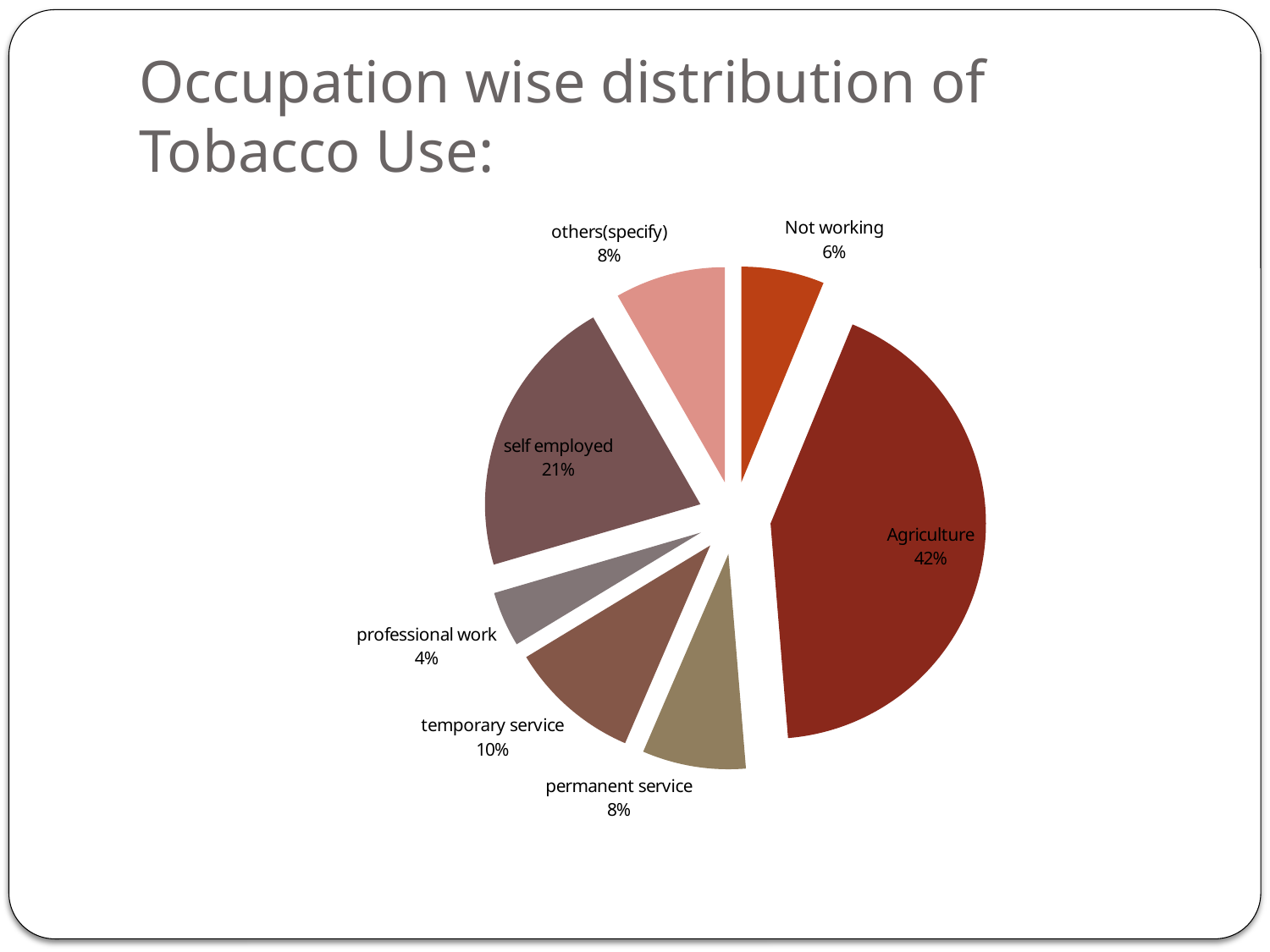
What is the difference in percentage points between Agriculture and self employed? 21 How many occupation categories are shown in the pie chart? 7 What is the title of the slide? Occupation wise distribution of Tobacco Use: Which is larger, temporary service or permanent service? temporary service What percentage of tobacco use is attributed to Agriculture? 42% Which occupation category has the largest share of the pie? Agriculture What type of chart is shown on the slide? pie chart Which two categories share the same value of 8%? others(specify) and permanent service What is the share for self employed? 21% Which occupation category has the smallest share of the pie? professional work What percentage is shown for temporary service? 10% What is the value for Not working? 6%